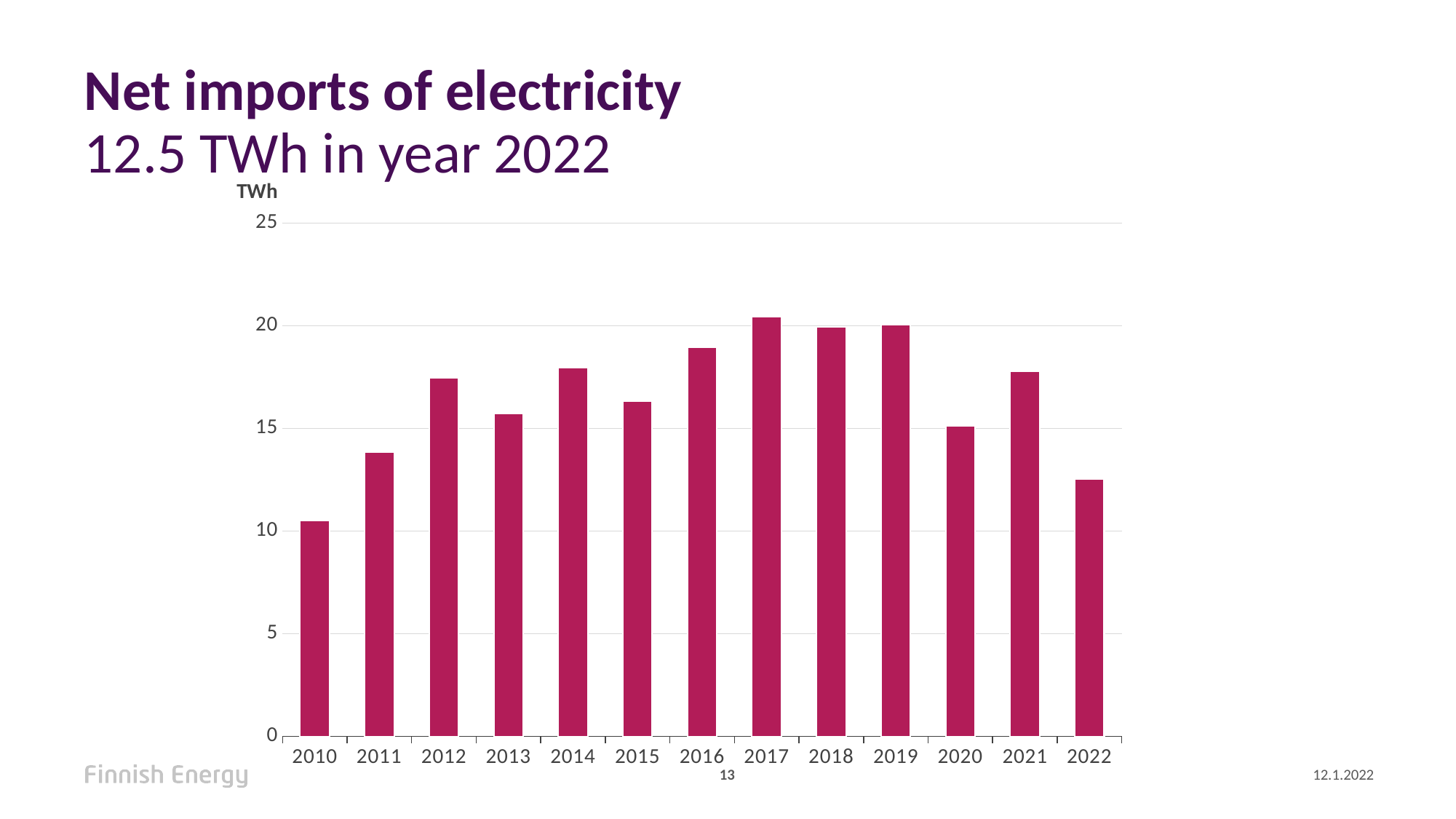
What is the net import of electricity in 2022 according to the slide? 12.5 TWh Which year has the lowest net imports of electricity? 2010 Is the value for 2010 greater or less than 15? less Is the value for 2017 greater or less than 20? greater Is the value for 2011 greater or less than 15? less How many years are shown on the x axis of the chart? 13 What kind of chart is shown on the slide? bar chart Which year has the larger value, 2012 or 2013? 2012 What unit is shown on the y axis of the chart? TWh Which year has the larger value, 2020 or 2021? 2021